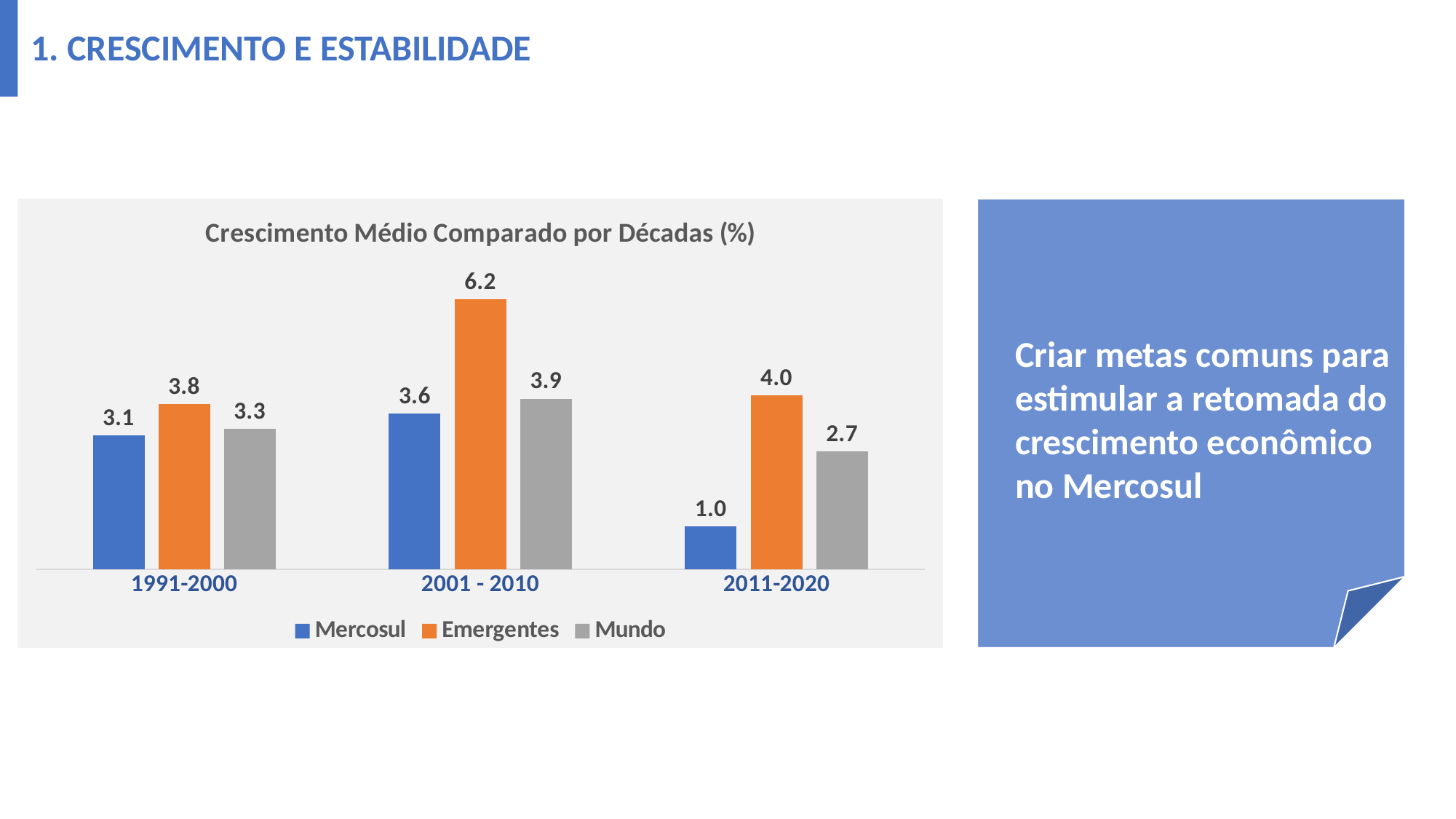
What is the difference between Emergentes and Mercosul in 2011-2020? 3.0 What is the value for Emergentes in 2001 - 2010? 6.2 Which decade has the highest value for Emergentes? 2001 - 2010 What is the value for Mundo in 2011-2020? 2.7 What kind of chart is shown? Bar chart Does the value for Mundo rise or fall from 2001 - 2010 to 2011-2020? Fall Which decade has the lowest value for Mercosul? 2011-2020 How many series does the legend list? 3 Which is larger in 1991-2000, Mundo or Mercosul? Mundo What is the title of the chart? Crescimento Médio Comparado por Décadas (%) What is the value for Mercosul in 1991-2000? 3.1 How many decades are shown on the x axis? 3